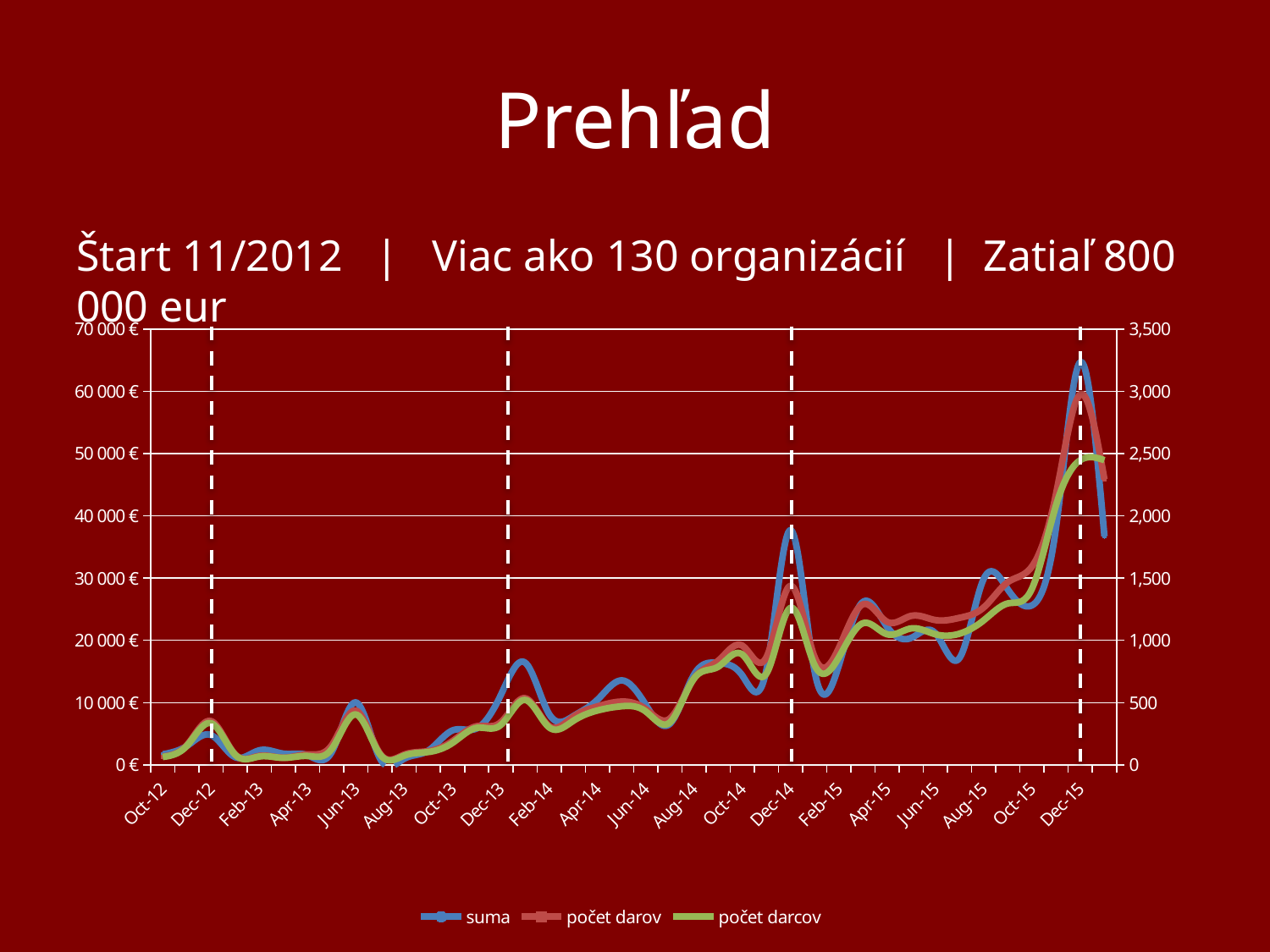
Overall, do the series rise or fall from Oct-12 to Dec-15? rise What are the three series named in the legend? suma, počet darov, počet darcov Is the value of suma at Aug-13 greater or less than 10 000 €? less What kind of chart is shown on the slide? line chart Is the value of počet darcov at Dec-15 greater or less than 2,000? greater In which month does the suma series reach its highest value? Dec-15 Is the value of suma at Dec-14 greater or less than 30 000 €? greater Which is larger, the suma value at Dec-14 or at Dec-15? Dec-15 How many series does the chart legend list? 3 What is the highest value shown on the left (euro) axis? 70 000 €